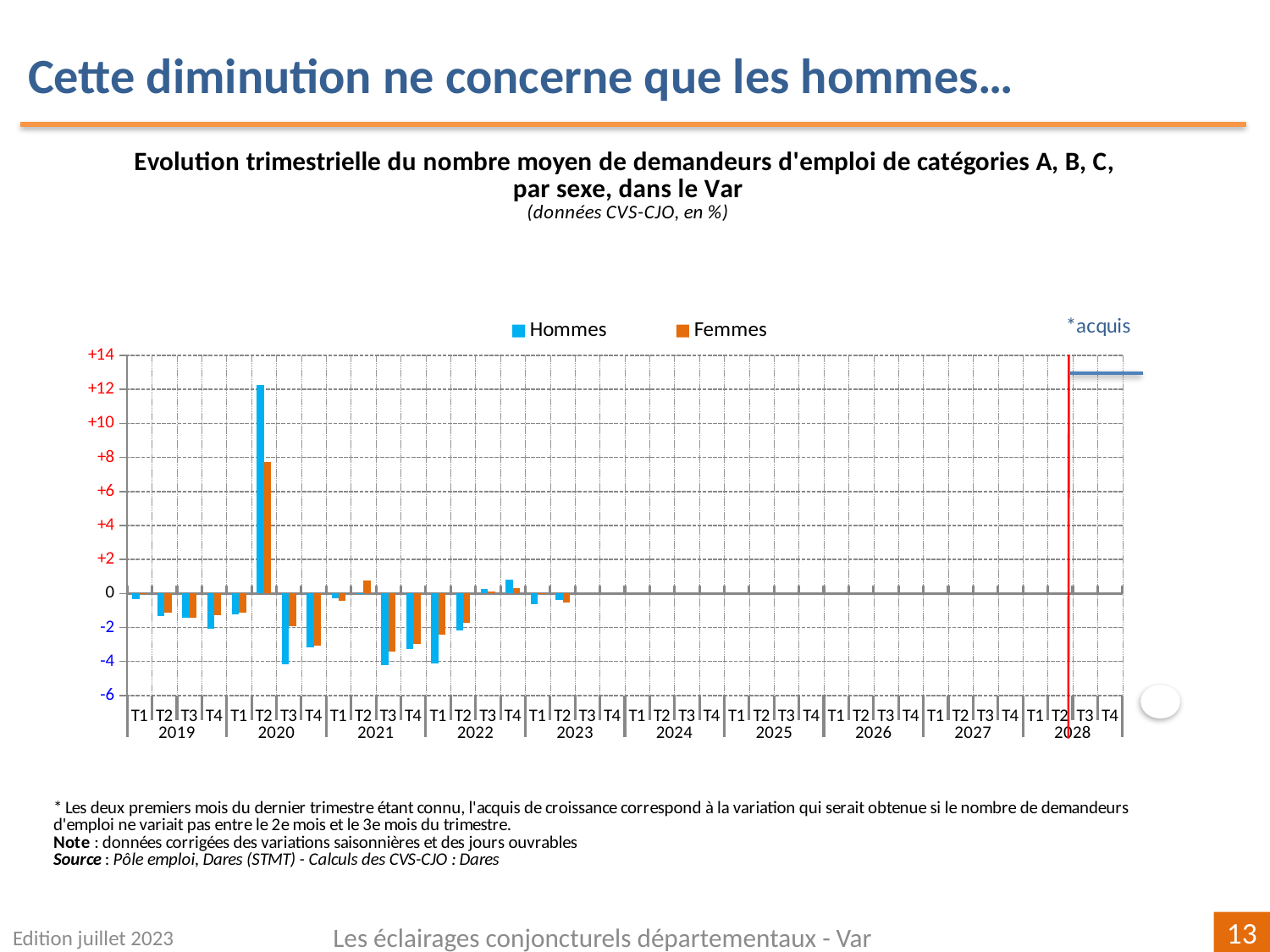
Is the value for Hommes in T2 2020 greater or less than +10? greater Is the value for Femmes in T2 2020 greater or less than +6? greater What kind of chart is shown on the slide? bar chart How many series does the legend list? 2 In which quarter does the Hommes series reach its highest value? T2 2020 How many years are labelled along the x axis? 10 In T2 2021, which series has the larger value, Hommes or Femmes? Femmes Is the value for Hommes in T3 2020 greater or less than -2? less What label is written next to the red vertical line at the right of the chart? *acquis In T2 2020, which series has the larger value, Hommes or Femmes? Hommes Which series is shown in blue in the legend? Hommes